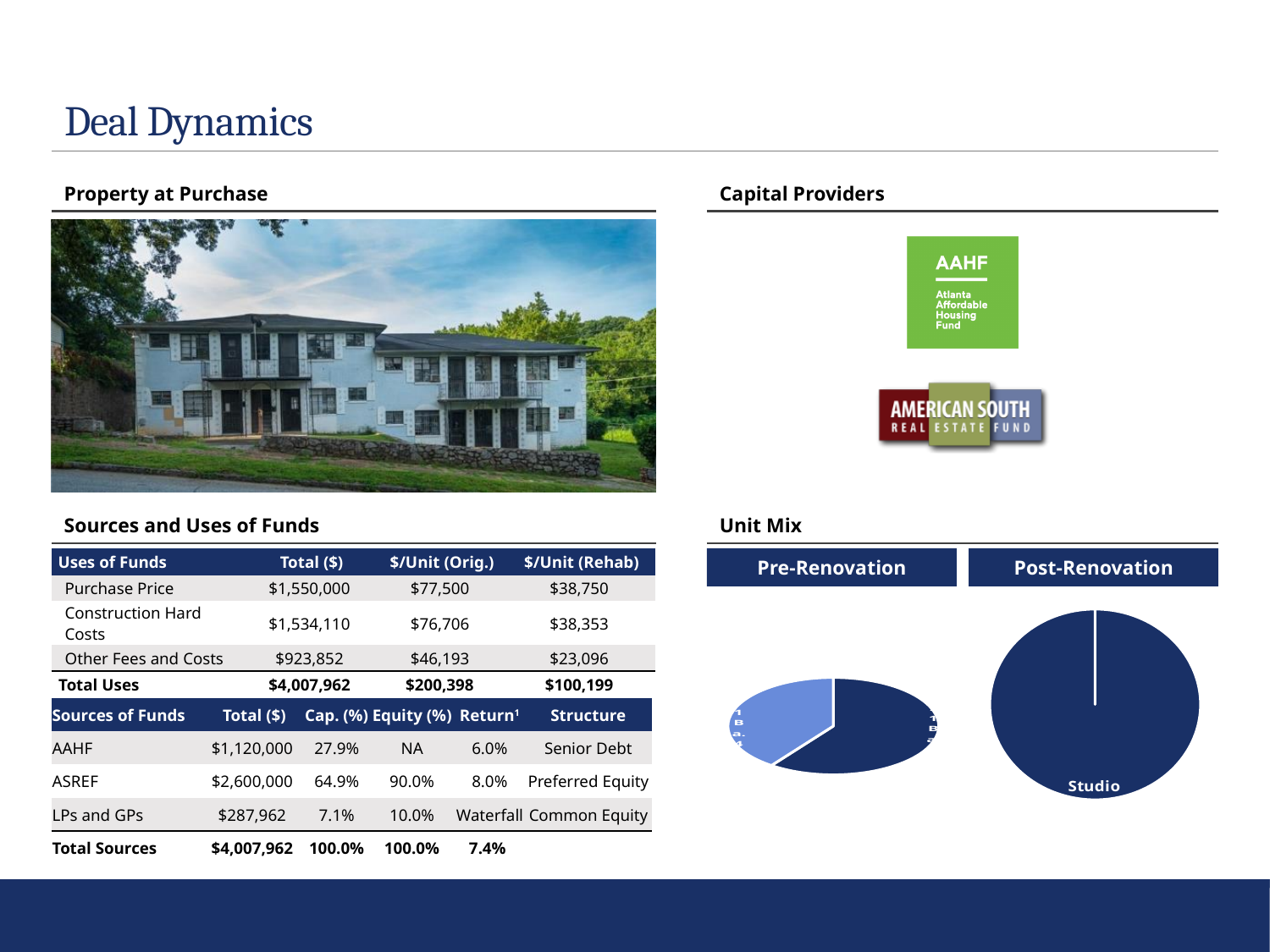
What is the only category shown in the Post-Renovation pie chart? Studio How many pie charts are shown in the Unit Mix section? 2 What kind of chart is used for the Pre-Renovation unit mix? Pie chart What share of the Post-Renovation pie chart does the Studio slice take up? 100% How many slices does the Post-Renovation pie chart have? 1 What kind of chart is used for the Post-Renovation unit mix? Pie chart What are the titles of the two pie charts in the Unit Mix section? Pre-Renovation and Post-Renovation In the Pre-Renovation pie chart, which slice is larger, the dark blue one or the light blue one? The dark blue one How many slices does the Pre-Renovation pie chart have? 2